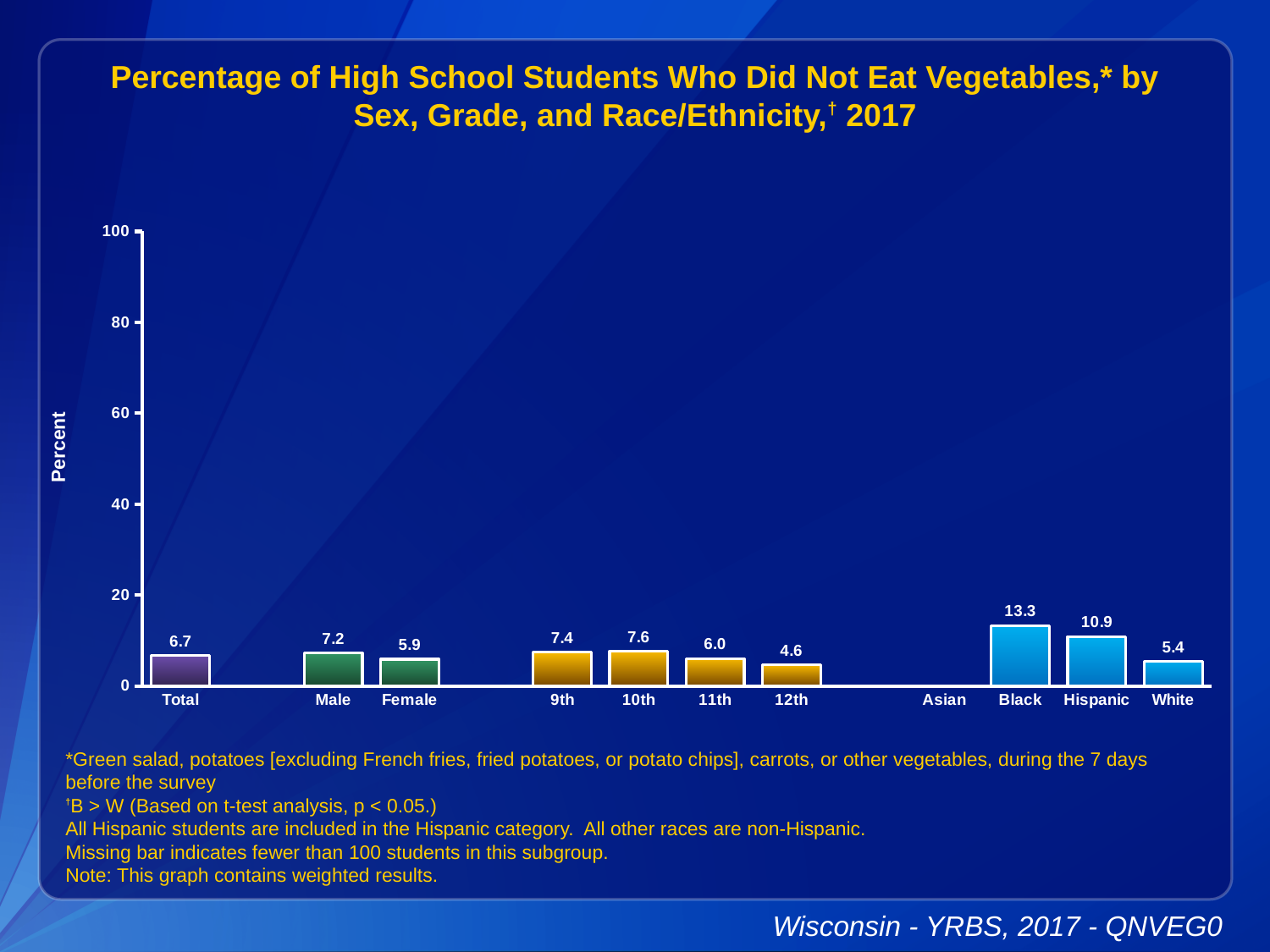
What is the value for Female? 5.9 Which category has the lowest value among those with a bar shown? 12th What kind of chart is this? bar chart What is the value for Hispanic? 10.9 Which category has the highest value? Black Which category has no bar shown? Asian What is the difference between the values for Black and White? 7.9 What is the difference between the values for Male and Female? 1.3 Which is larger, the value for 9th grade or 10th grade? 10th What is the value for Total? 6.7 Is the value for Black greater or less than 20? less What is the value for 12th grade? 4.6